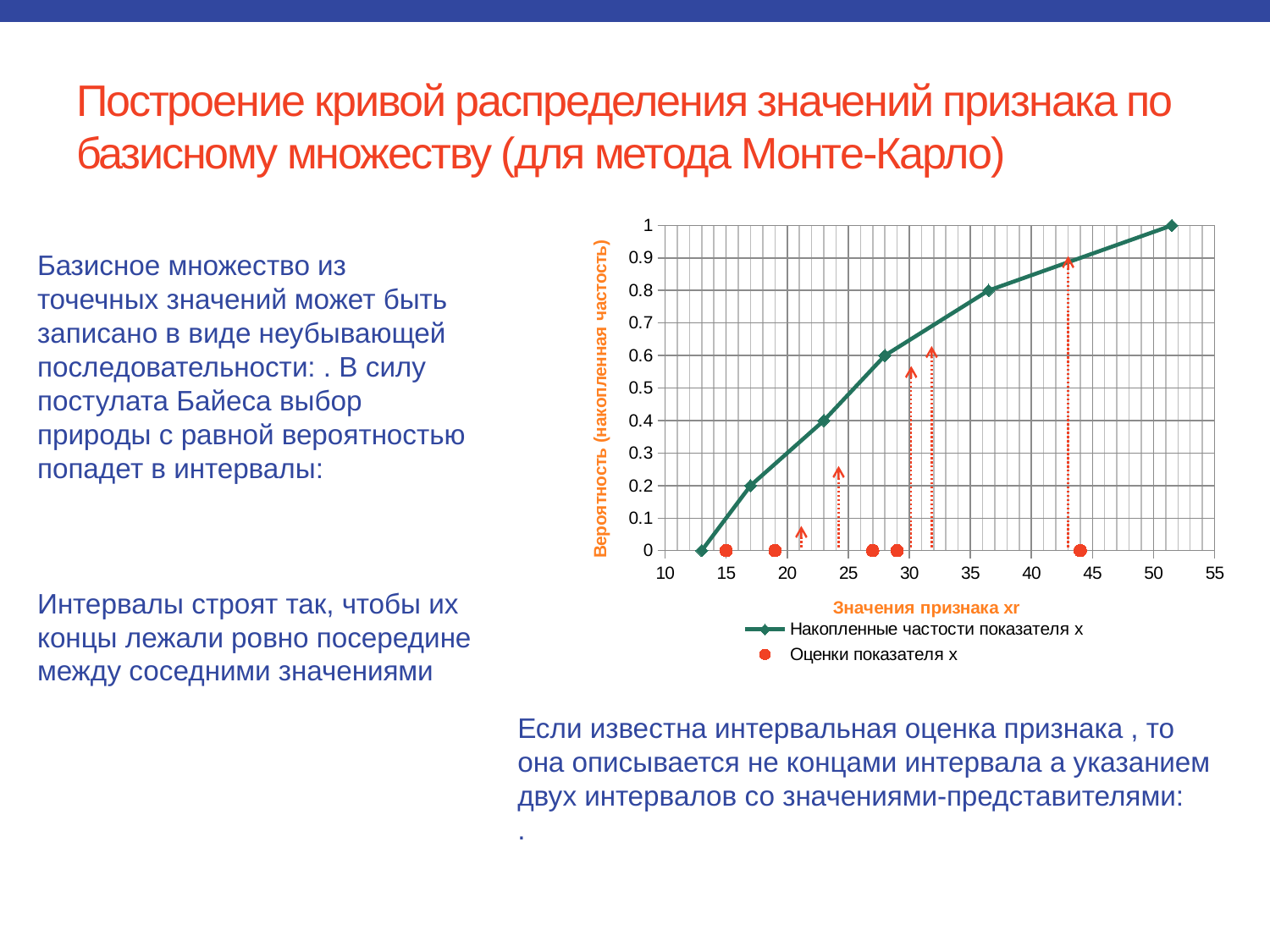
What kind of chart is shown on the slide? line chart What is the title of the horizontal axis of the chart? Значения признака xr Do the values of the 'Накопленные частости показателя x' line rise or fall as x increases? rise Is the value of the 'Накопленные частости показателя x' line at its fifth point (near x = 36) greater or less than 0.7? greater How many diamond-marked points are plotted on the 'Накопленные частости показателя x' line? 6 How many series does the chart legend list? 2 What is the lowest value of the 'Накопленные частости показателя x' line? 0 How many red dots of the series 'Оценки показателя x' are plotted on the chart? 5 What is the highest value reached by the 'Накопленные частости показателя x' line? 1 Which is larger: the value of the 'Накопленные частости показателя x' line at its third point (near x = 23) or at its fourth point (near x = 28)? the fourth point (near x = 28) What is the name of the first series in the chart legend? Накопленные частости показателя x Is the value of the 'Накопленные частости показателя x' line at its second point (near x = 17) greater or less than 0.5? less